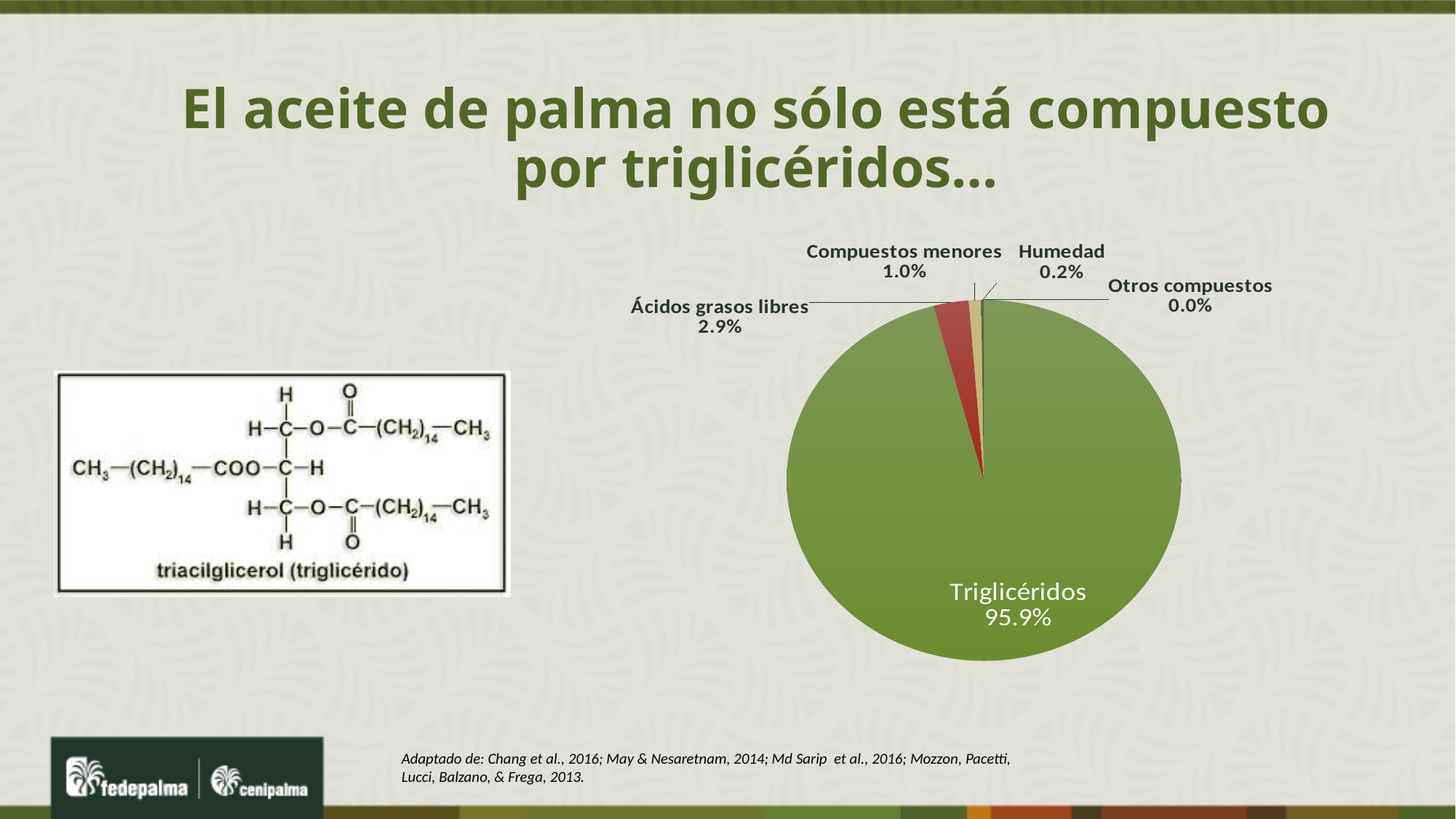
What percentage is shown for Ácidos grasos libres? 2.9% Which is larger, the share of Humedad or the share of Compuestos menores? Compuestos menores Which category has the smallest share in the pie chart? Otros compuestos What share of palm oil is Triglicéridos according to the pie chart? 95.9% What percentage is shown for Humedad? 0.2% What percentage is shown for Compuestos menores? 1.0% What is the difference between the shares of Ácidos grasos libres and Compuestos menores? 1.9% What colour is the Ácidos grasos libres slice in the pie chart? red Which slice of the pie chart is the largest? Triglicéridos What kind of chart is shown on the slide? pie chart What percentage is shown for Otros compuestos? 0.0% How many categories are shown in the pie chart? 5